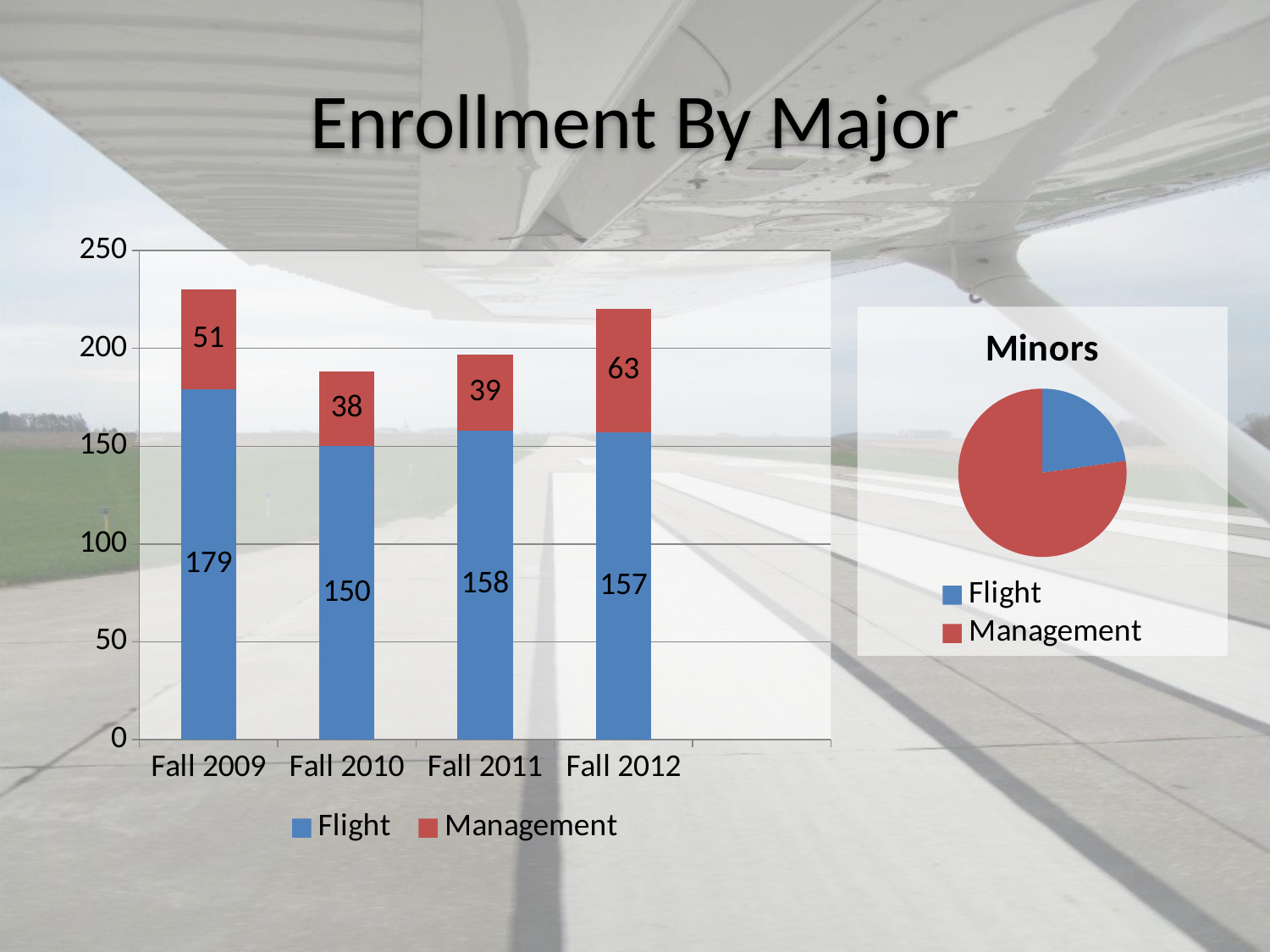
In the bar chart on the left, is the total stacked bar for Fall 2010 greater or less than 200? less How many series does the legend of the bar chart on the left list? 2 What kind of chart is the chart titled Minors? Pie chart In the bar chart on the left, what is the difference between the Flight values for Fall 2009 and Fall 2010? 29 In the bar chart on the left, which semester has the highest Flight value? Fall 2009 In the bar chart on the left, what is the Management value for Fall 2012? 63 In the Minors pie chart, which slice is larger, Flight or Management? Management In the bar chart on the left, which semester has the lowest Management value? Fall 2010 In the bar chart on the left, is the Management value larger for Fall 2011 or Fall 2012? Fall 2012 In the bar chart on the left, what is the total of the stacked bar for Fall 2012? 220 In the bar chart on the left, what is the Flight value for Fall 2009? 179 How many semesters are shown on the x axis of the bar chart on the left? 4